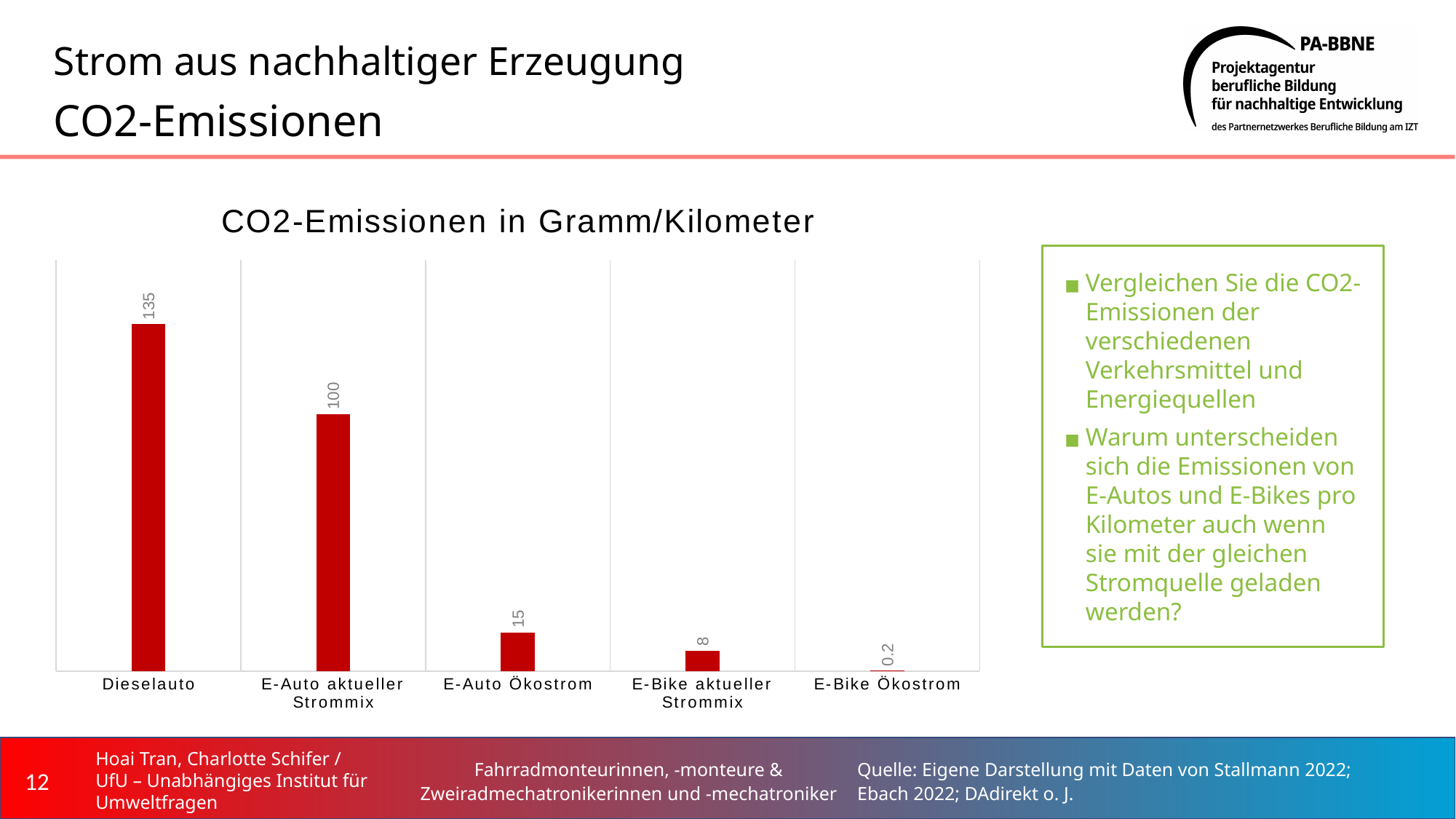
What is the difference between the values for Dieselauto and E-Auto aktueller Strommix? 35 What is the title of the chart? CO2-Emissionen in Gramm/Kilometer What is the value shown for E-Bike Ökostrom? 0.2 What is the difference between the values for E-Auto Ökostrom and E-Bike aktueller Strommix? 7 Which is larger, the value for E-Auto Ökostrom or the value for E-Bike aktueller Strommix? E-Auto Ökostrom What is the value shown for E-Auto aktueller Strommix? 100 What is the value shown for E-Auto Ökostrom? 15 Which category has the highest CO2 emissions? Dieselauto What kind of chart is shown on the slide? Bar chart How many categories are shown in the chart? 5 What is the CO2 emission value for Dieselauto? 135 Which category has the lowest CO2 emissions? E-Bike Ökostrom